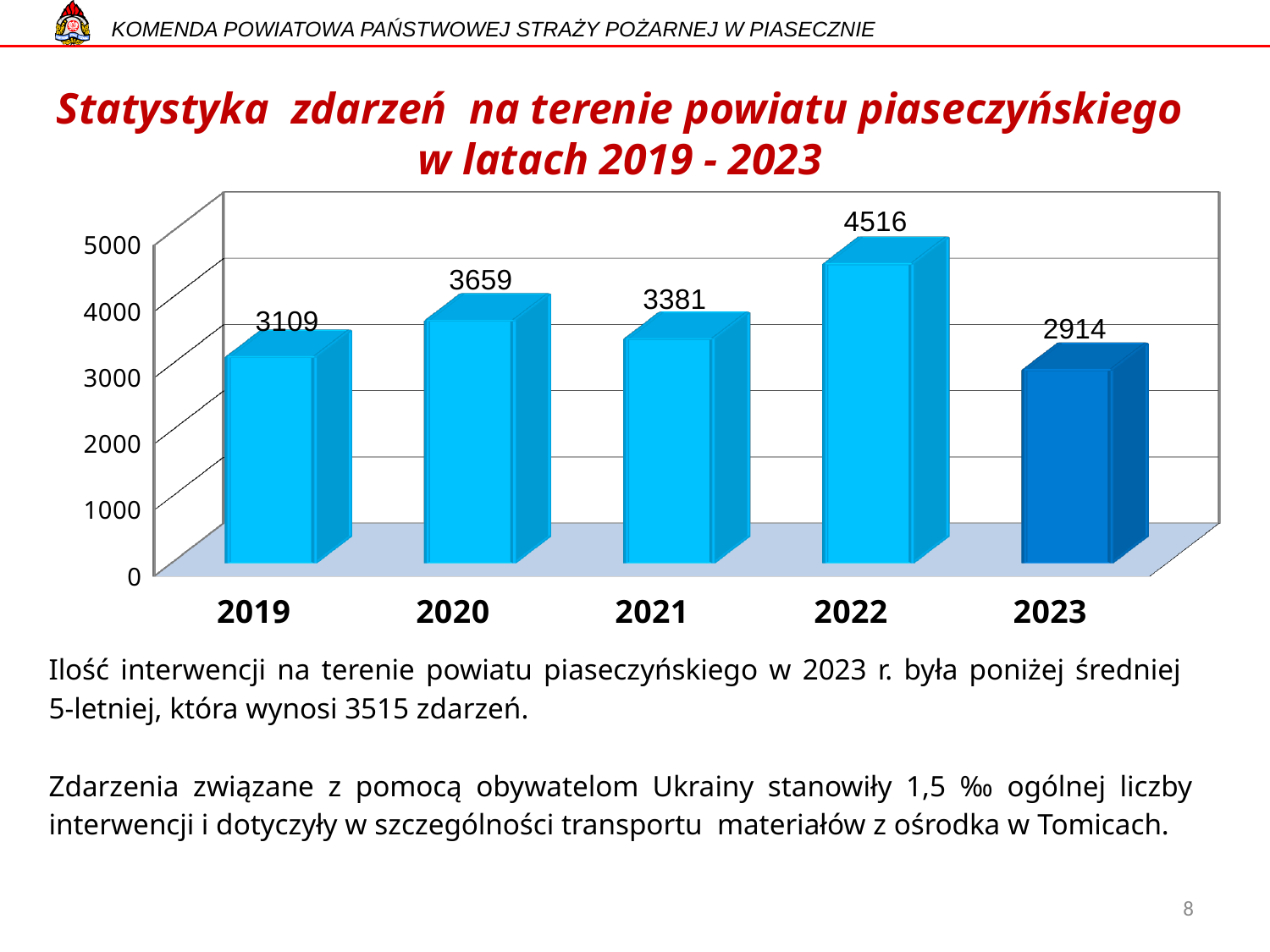
What kind of chart is shown on the slide? bar chart What is the title of the chart? Statystyka zdarzeń na terenie powiatu piaseczyńskiego w latach 2019 - 2023 What is the value for 2022? 4516 What is the value for 2019? 3109 What is the difference between the values for 2020 and 2021? 278 Which is larger, the value for 2020 or the value for 2021? 2020 Is the value for 2022 greater or less than 4000? greater What is the value for 2023? 2914 Which year has the highest value? 2022 How many years are shown on the chart? 5 Which year has the lowest value? 2023 What is the difference between the values for 2022 and 2023? 1602